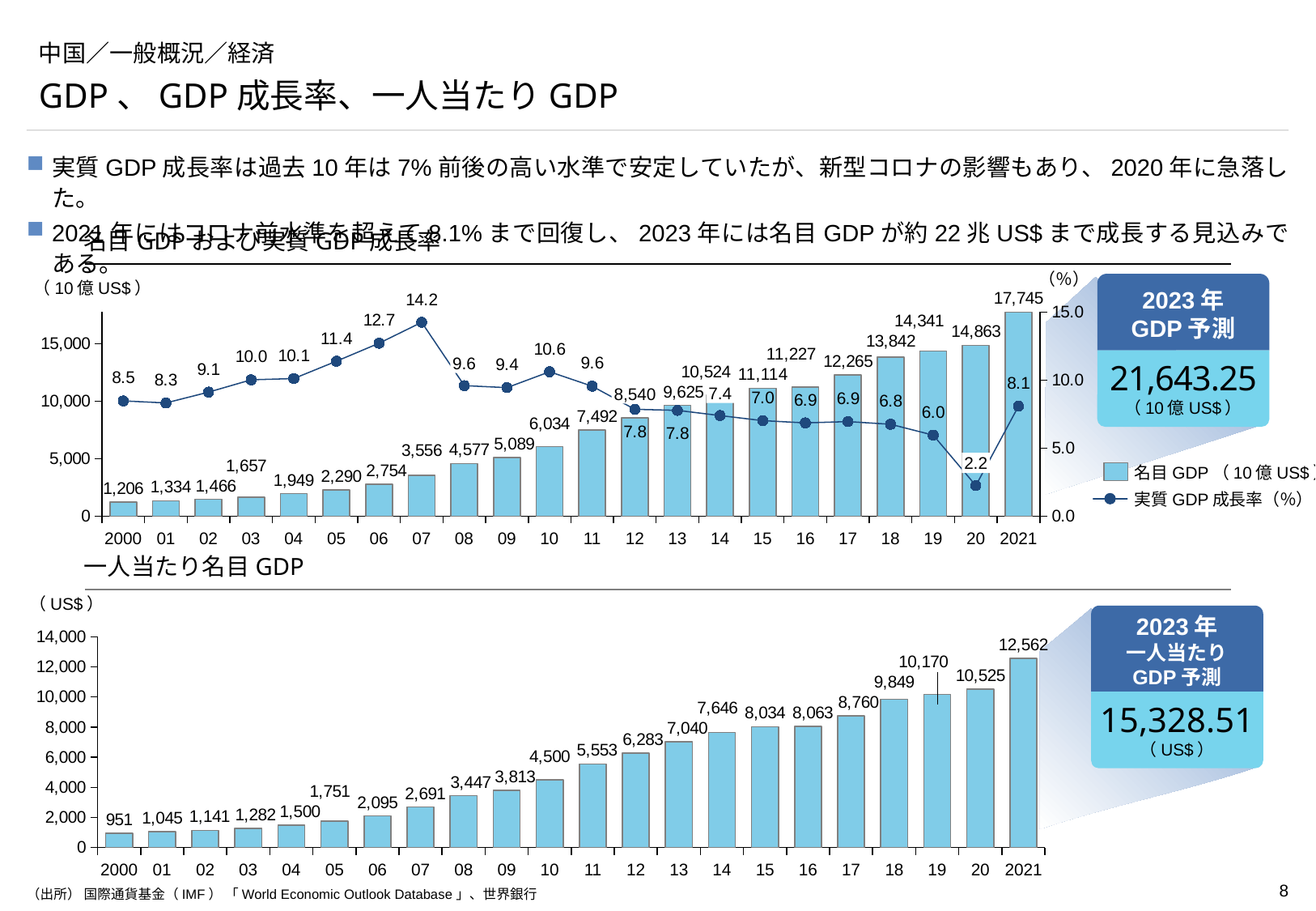
In the top chart (名目GDPおよび実質GDP成長率), what is the real GDP growth rate for 2020? 2.2 In the bottom chart (一人当たり名目GDP), do the values generally rise or fall from 2000 to 2021? rise In the top chart (名目GDPおよび実質GDP成長率), what is the nominal GDP value for 2021? 17,745 In the bottom chart (一人当たり名目GDP), how many years are plotted? 22 In the bottom chart (一人当たり名目GDP), what is the value for 2000? 951 In the top chart (名目GDPおよび実質GDP成長率), which year has the lowest real GDP growth rate? 20 In the top chart (名目GDPおよび実質GDP成長率), how many series does the legend list? 2 In the bottom chart (一人当たり名目GDP), what is the value for 2021? 12,562 What kind of chart is the bottom chart (一人当たり名目GDP)? bar chart In the top chart (名目GDPおよび実質GDP成長率), what is the difference in nominal GDP between 2021 and 20? 2,882 In the top chart (名目GDPおよび実質GDP成長率), which year has the highest real GDP growth rate? 07 In the top chart (名目GDPおよび実質GDP成長率), is the real GDP growth rate for 2021 greater or less than the rate for 19? greater